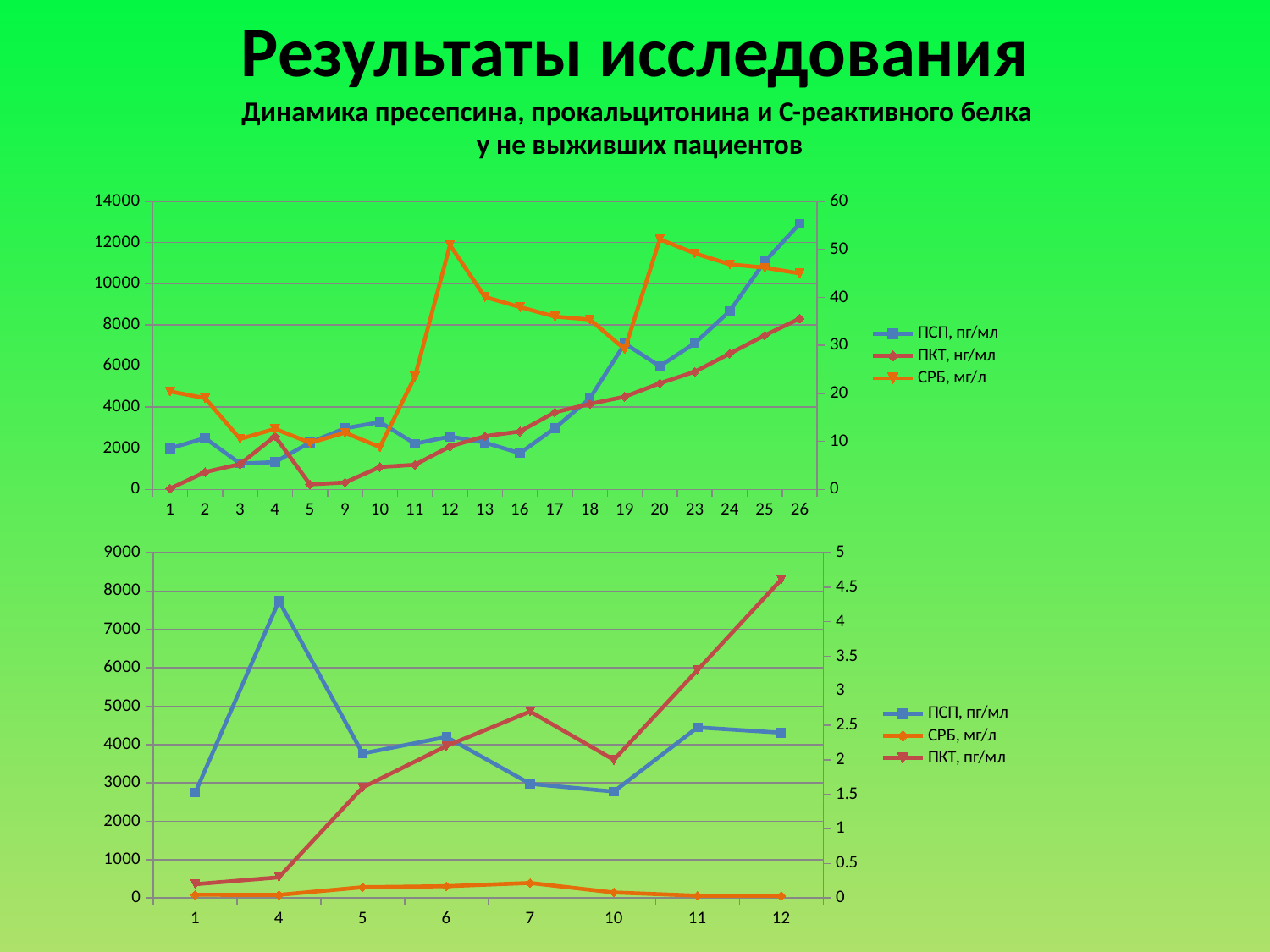
In the top chart, is the value of ПСП, пг/мл at category 26 greater or less than 12000? greater In the bottom chart, at which x-axis category is the ПСП, пг/мл series highest? 4 How many series does the legend of the top chart list? 3 What kind of chart is the top chart on the slide? line chart In the bottom chart, which is larger: ПСП, пг/мл at category 4 or at category 5? category 4 How many points are plotted along the x axis of the top chart? 19 In the bottom chart, does the ПКТ, пг/мл series overall rise or fall from category 1 to category 12? rise Which series are listed in the legend of the bottom chart? ПСП, пг/мл; СРБ, мг/л; ПКТ, пг/мл In the top chart, at which x-axis category is the ПСП, пг/мл series highest? 26 In the top chart, is the value of ПСП, пг/мл at category 1 greater or less than 4000? less In the bottom chart, is the value of ПСП, пг/мл at category 4 greater or less than 7000? greater How many points are plotted along the x axis of the bottom chart? 8